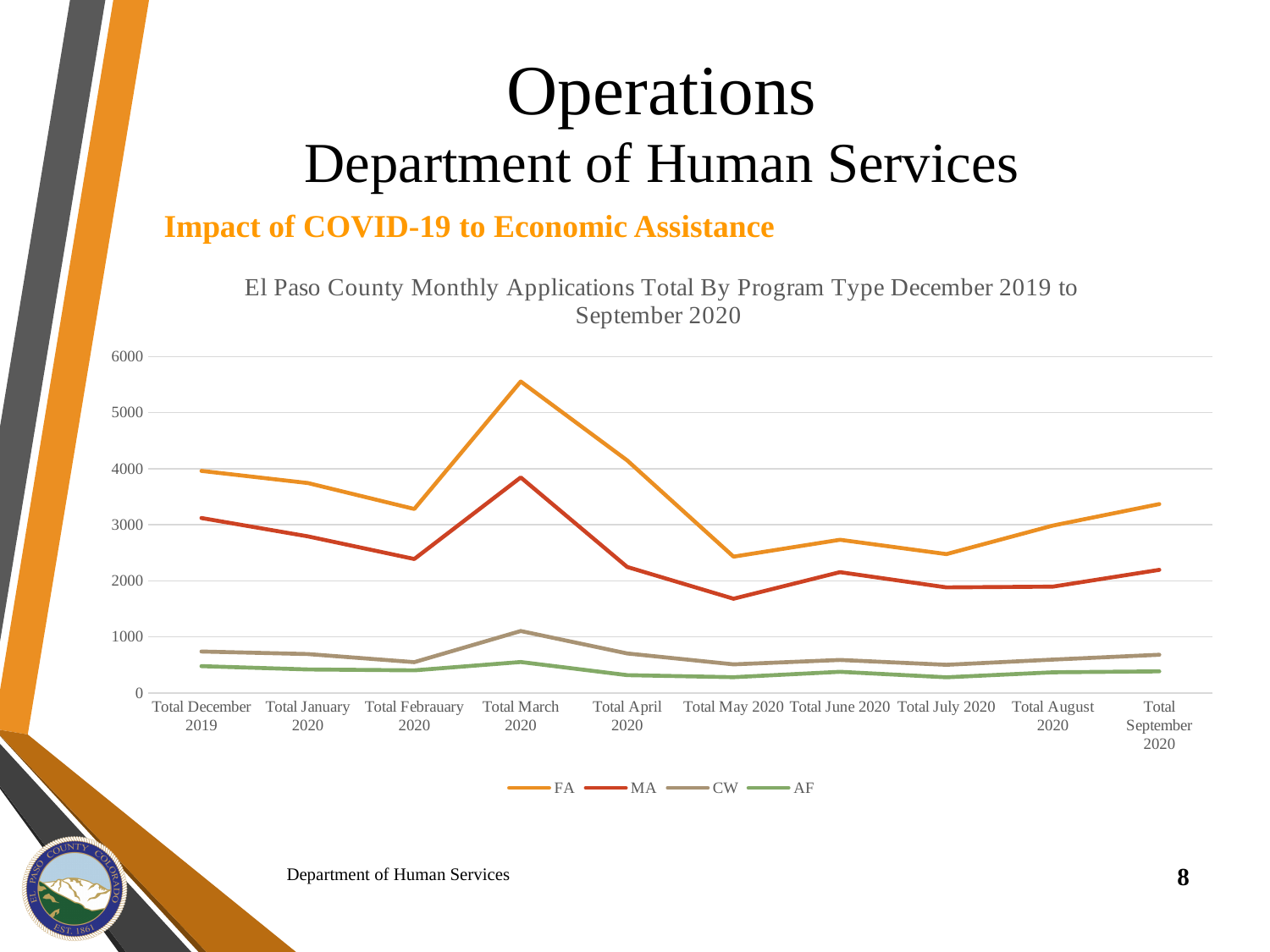
Does the FA series rise or fall from Total July 2020 to Total September 2020? rise What kind of chart is shown on the slide? line chart In Total March 2020, which series has the larger value, FA or MA? FA How many series does the legend list? 4 What is the title of the chart? El Paso County Monthly Applications Total By Program Type December 2019 to September 2020 Is the value for AF in Total December 2019 greater or less than 1000? less Is the value for FA in Total March 2020 greater or less than 5000? greater In which month does the MA series reach its lowest value? Total May 2020 Does the FA series rise or fall from Total March 2020 to Total May 2020? fall In which month does the FA series reach its highest value? Total March 2020 How many months are plotted along the x axis? 10 Is the value for MA in Total Februaury 2020 greater or less than 3000? less